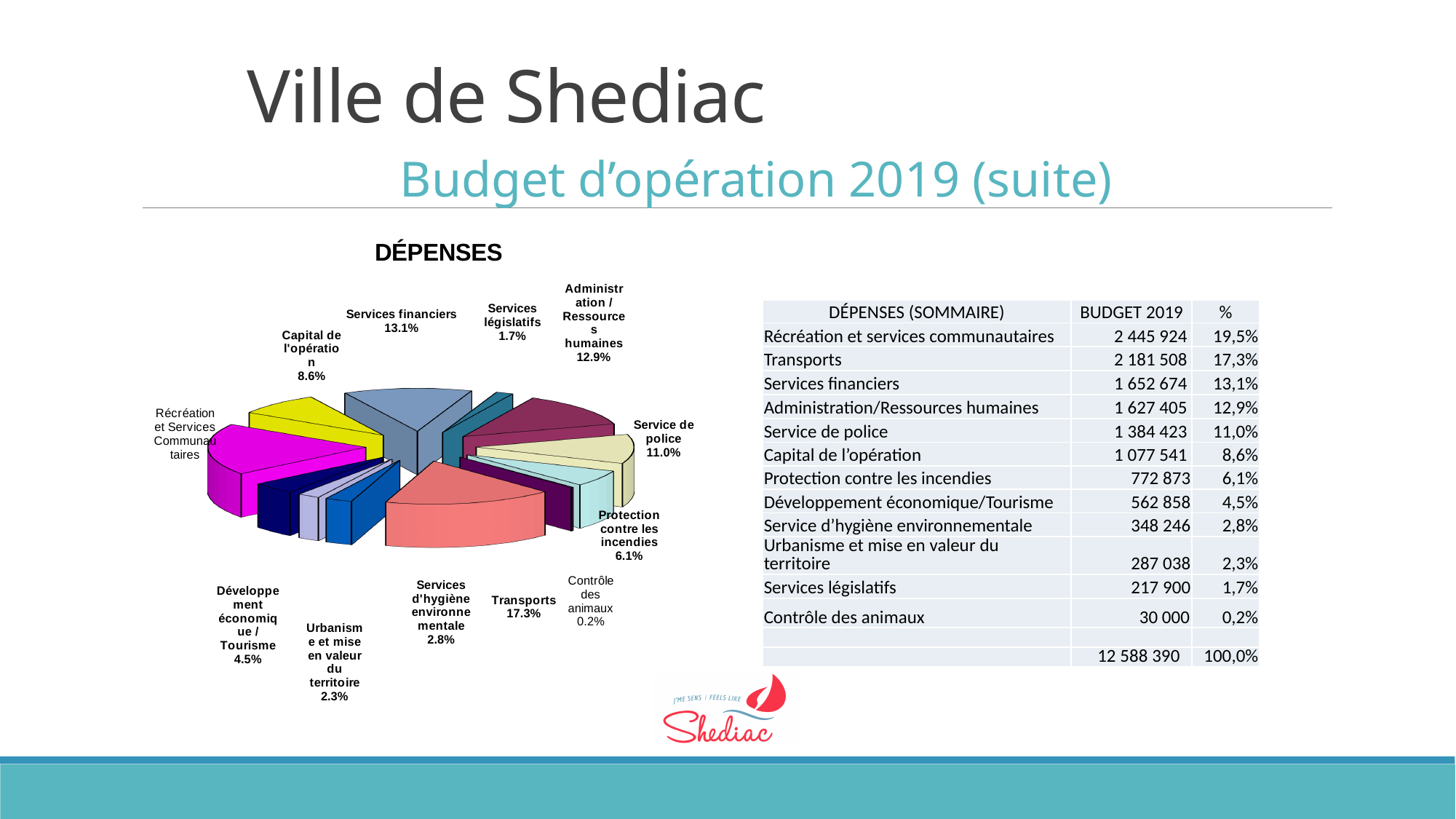
What percentage is shown for Protection contre les incendies in the pie chart? 6.1% What is the title of the pie chart? DÉPENSES What percentage is shown for Capital de l'opération in the pie chart? 8.6% How many slices does the pie chart have? 12 What percentage is shown for Service de police in the pie chart? 11.0% Which is larger in the pie chart, Service de police or Capital de l'opération? Service de police What percentage does the Services financiers slice represent in the pie chart? 13.1% What kind of chart is shown on the slide? Pie chart By how many percentage points does Transports exceed Services financiers in the pie chart? 4.2 What percentage is shown for Services législatifs in the pie chart? 1.7% Which slice of the pie chart has the smallest share? Contrôle des animaux What percentage does the Transports slice represent in the pie chart? 17.3%